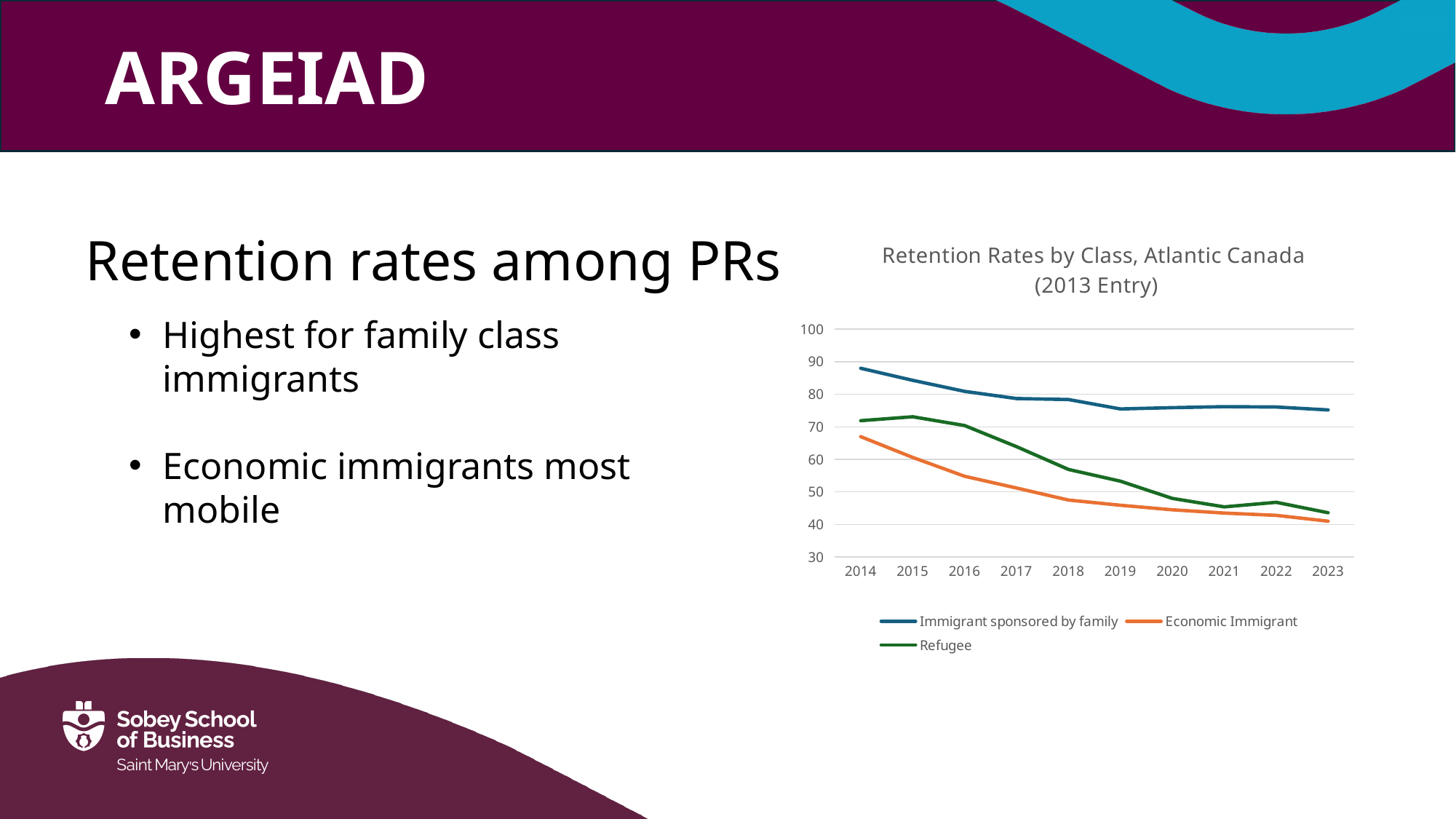
In 2018, which is larger: the retention rate for Refugee or for Economic Immigrant? Refugee Do the retention rates for Economic Immigrant rise or fall from 2014 to 2023? Fall Which series is shown in orange in the chart? Economic Immigrant How many years are plotted along the x axis of the chart? 10 Is the value for Refugee in 2018 greater or less than 60? less Is the value for Economic Immigrant in 2023 greater or less than 50? less How many series does the legend of the chart list? 3 What is the title of the chart? Retention Rates by Class, Atlantic Canada (2013 Entry) Which series has the highest retention rate in 2023? Immigrant sponsored by family Which series has the lowest retention rate in 2014? Economic Immigrant Is the value for Immigrant sponsored by family in 2014 greater or less than 80? greater What kind of chart is shown on the slide? Line chart